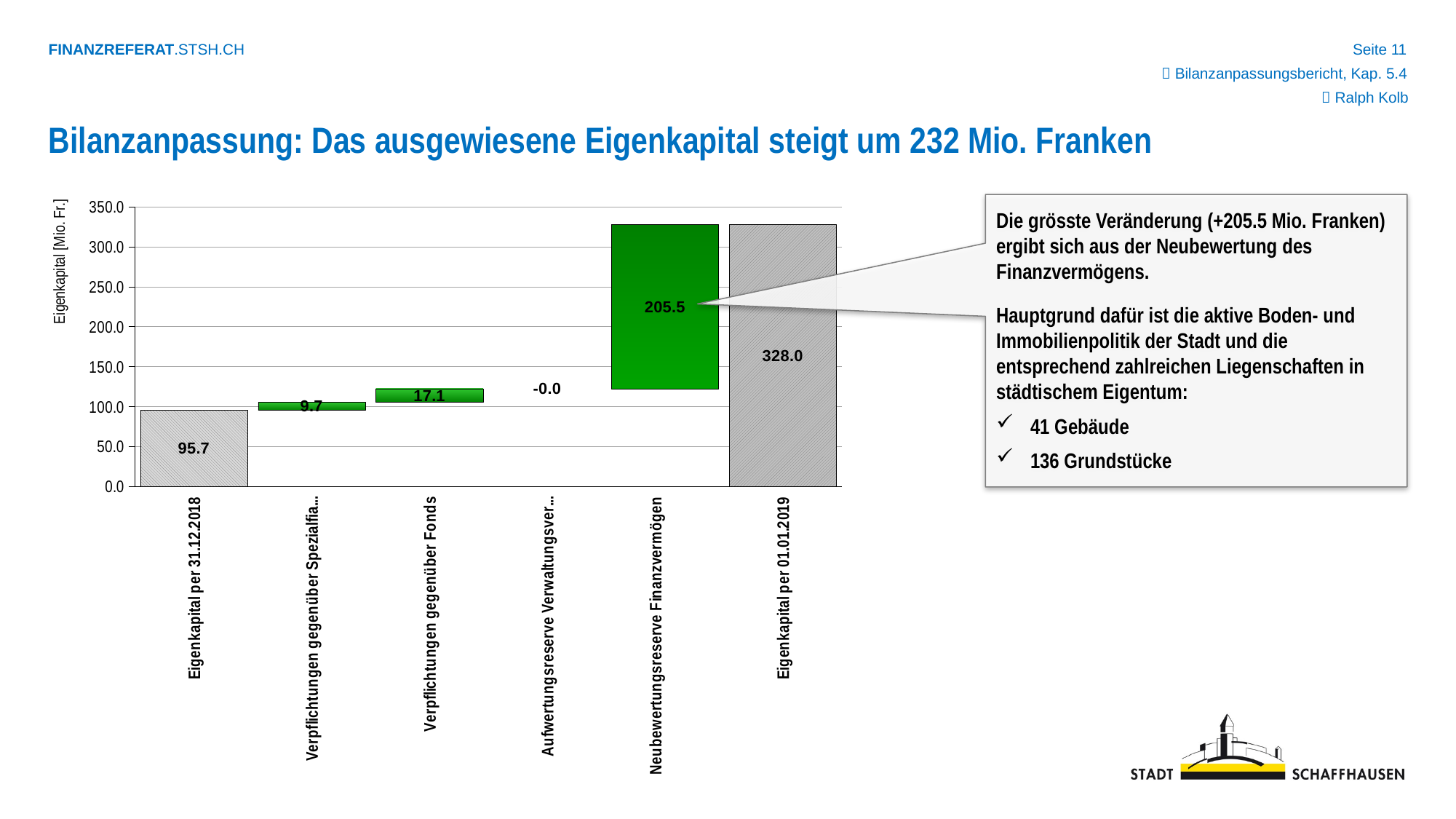
Is the value for Eigenkapital per 01.01.2019 greater or less than 300.0? greater What is the value for Neubewertungsreserve Finanzvermögen? 205.5 What is the label of the y axis? Eigenkapital [Mio. Fr.] Which is larger: Neubewertungsreserve Finanzvermögen or Verpflichtungen gegenüber Fonds? Neubewertungsreserve Finanzvermögen Which category has the highest value? Eigenkapital per 01.01.2019 What is the difference between Neubewertungsreserve Finanzvermögen and Verpflichtungen gegenüber Fonds? 188.4 What is the value for Verpflichtungen gegenüber Fonds? 17.1 What is the value for Eigenkapital per 31.12.2018? 95.7 How many categories are shown on the x axis? 6 What kind of chart is shown on the slide? bar chart What is the difference between Eigenkapital per 01.01.2019 and Eigenkapital per 31.12.2018? 232.3 What is the value for Eigenkapital per 01.01.2019? 328.0